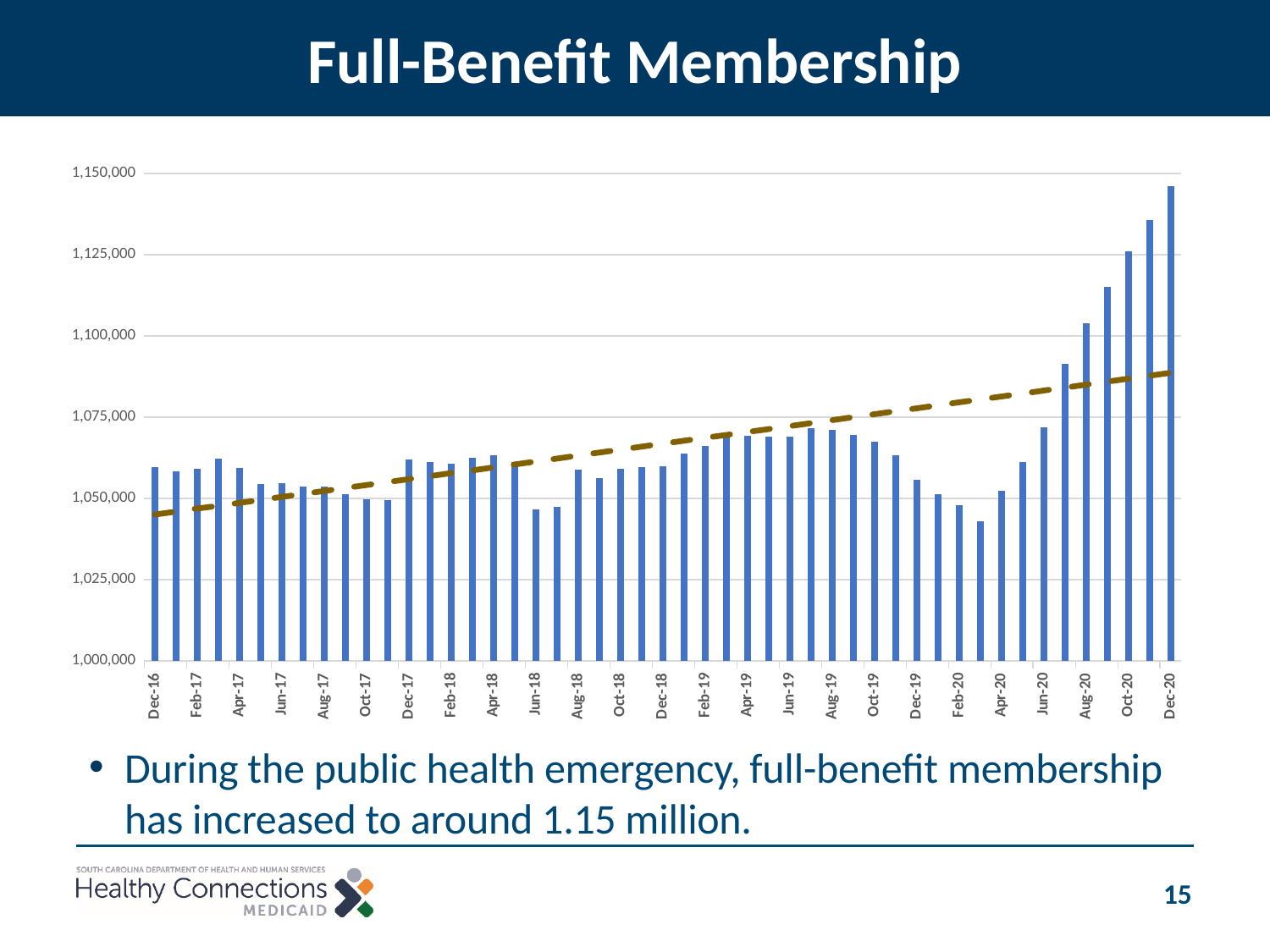
Is the value for Jun-20 greater or less than 1,075,000? less Which is larger, the value for Jun-18 or the value for Jun-19? Jun-19 Which is larger, the value for Dec-16 or the value for Dec-20? Dec-20 Is the value for Dec-16 greater or less than 1,050,000? greater Do the values generally rise or fall from Jun-20 to Dec-20? Rise What is the title of the chart? Full-Benefit Membership What kind of chart is shown on the slide? Bar chart Is the value for Dec-20 greater or less than 1,125,000? greater What is the highest value shown on the vertical axis? 1,150,000 Which month has the highest full-benefit membership in the chart? Dec-20